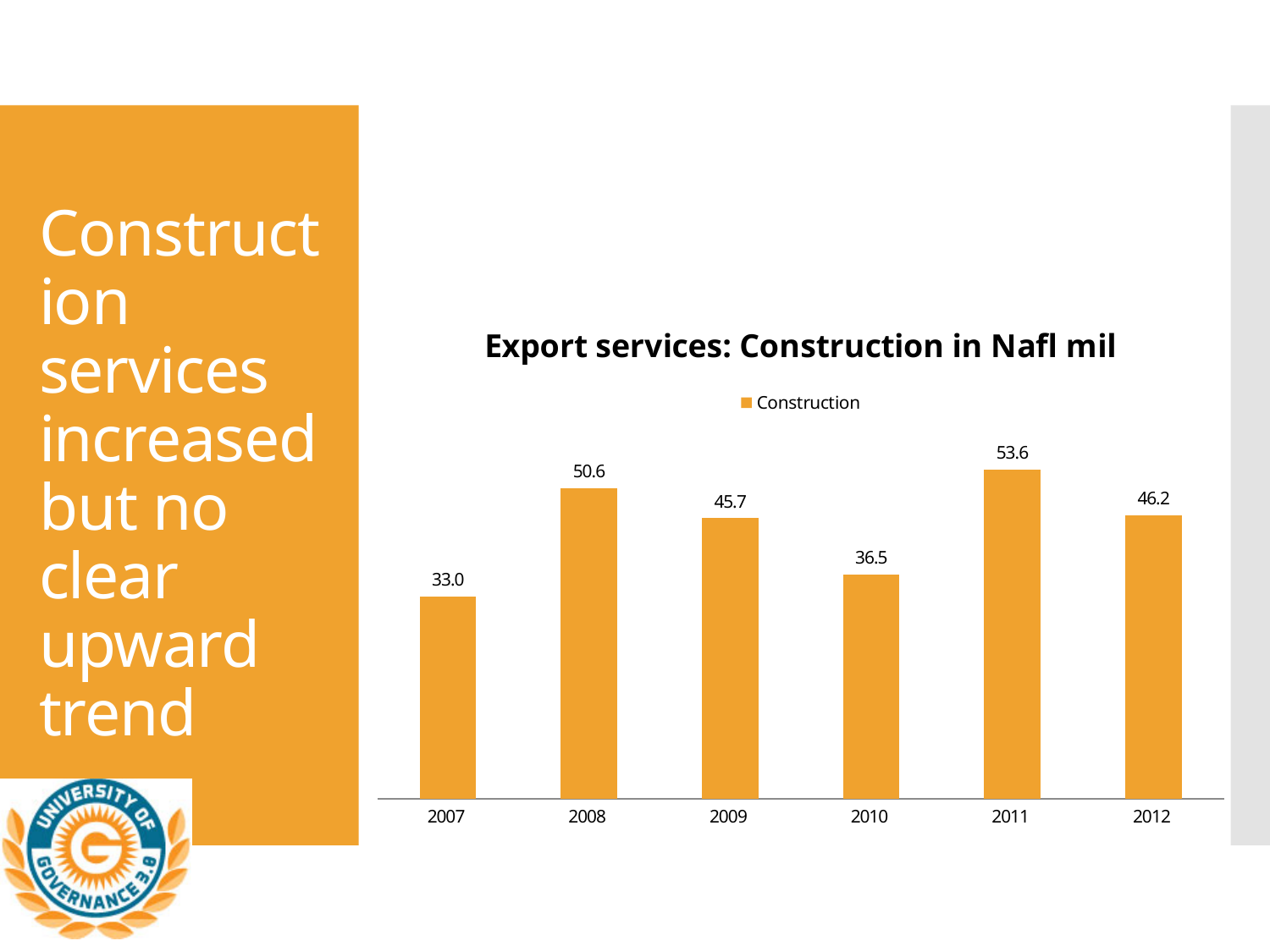
Which is larger, the value for 2009 or the value for 2012? 2012 Which year has the highest value? 2011 What is the value for 2010? 36.5 How many series does the legend list? 1 What is the difference between the values for 2011 and 2010? 17.1 How many years are shown on the x axis? 6 What is the value for 2007? 33.0 What kind of chart is this? bar chart What is the value for 2012? 46.2 What is the title of the chart? Export services: Construction in Nafl mil Which year has the lowest value? 2007 What is the difference between the values for 2008 and 2007? 17.6